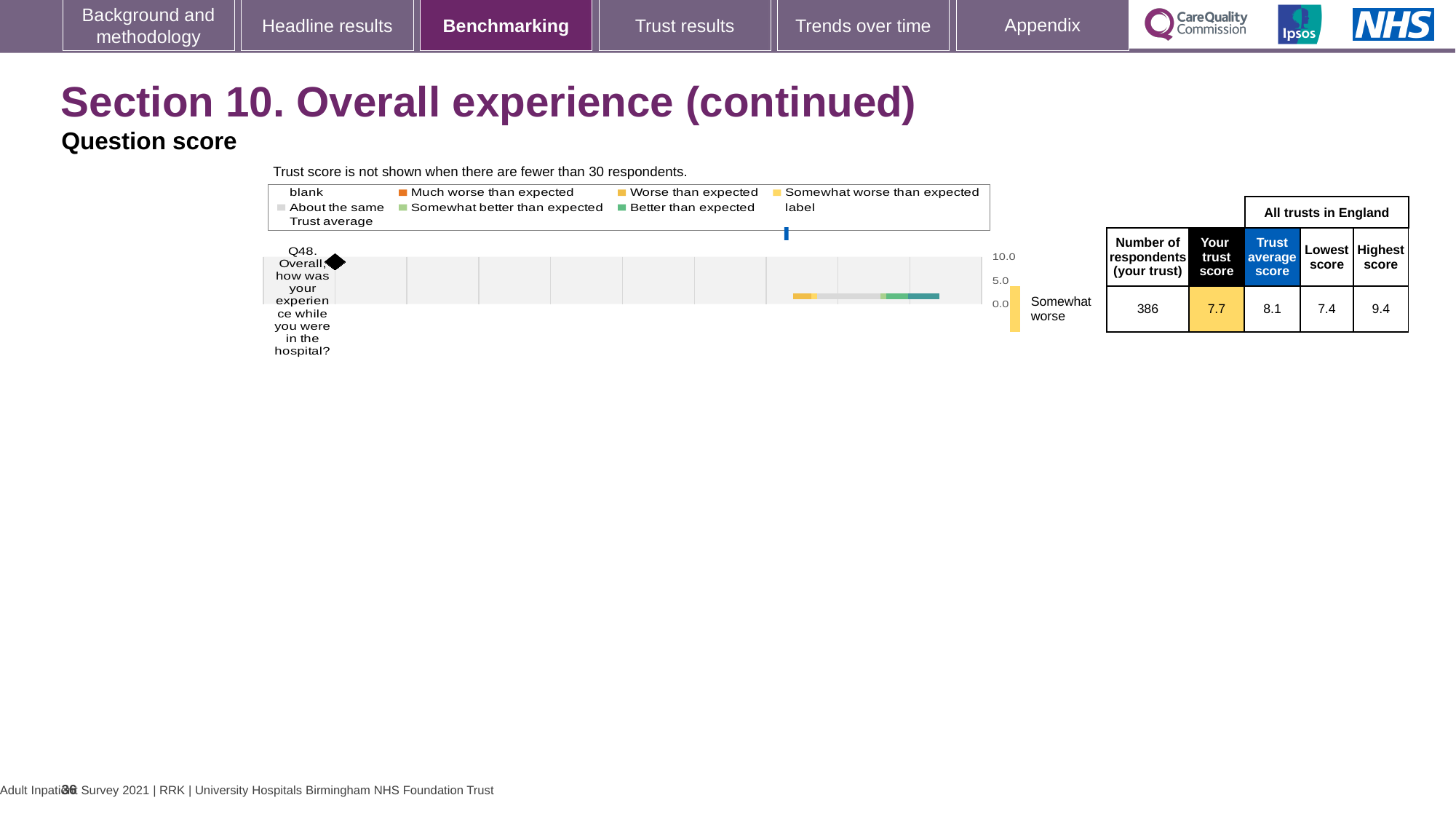
What is the number of respondents for your trust for Q48? 386 What is your trust score for Q48? 7.7 How many questions are plotted in the benchmarking chart? 1 What is the lowest score for Q48 across all trusts in England? 7.4 What is the highest score for Q48 across all trusts in England? 9.4 What is the difference between the highest score and the lowest score for Q48? 2.0 What is the maximum value shown on the chart's score axis? 10.0 What is the benchmark category label shown next to the Q48 bar? Somewhat worse What kind of chart is used to show the Q48 benchmarking result? bar chart What is the trust average score for Q48 across all trusts in England? 8.1 Which is larger for Q48, your trust score or the trust average score? Trust average score Which question is shown in the benchmarking chart? Q48. Overall, how was your experience while you were in the hospital?